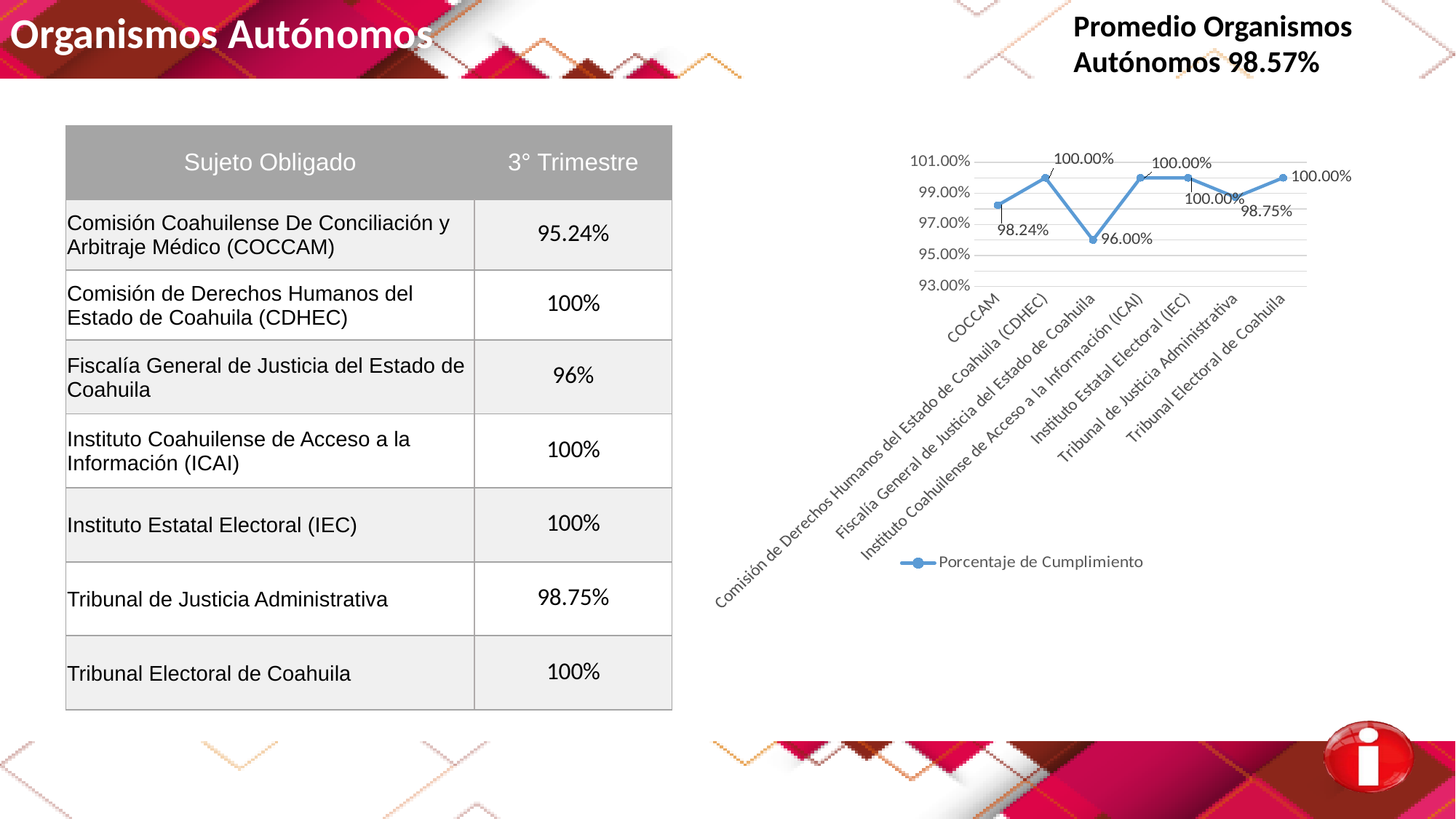
Does the line rise or fall between Comisión de Derechos Humanos del Estado de Coahuila (CDHEC) and Fiscalía General de Justicia del Estado de Coahuila? fall Which is larger, the value for Tribunal de Justicia Administrativa or the value for Fiscalía General de Justicia del Estado de Coahuila? Tribunal de Justicia Administrativa How many categories are plotted on the chart? 7 What kind of chart is shown on the slide? line chart How many series does the chart legend list? 1 What is the value plotted for Tribunal de Justicia Administrativa? 98.75% What is the value plotted for Instituto Estatal Electoral (IEC)? 100.00% What is the value plotted for Fiscalía General de Justicia del Estado de Coahuila? 96.00% What is the difference between the value for Tribunal Electoral de Coahuila and the value for Fiscalía General de Justicia del Estado de Coahuila? 4.00% Which category has the lowest value on the chart? Fiscalía General de Justicia del Estado de Coahuila Is the value for Fiscalía General de Justicia del Estado de Coahuila greater or less than 97.00%? less What is the name of the series shown in the chart legend? Porcentaje de Cumplimiento